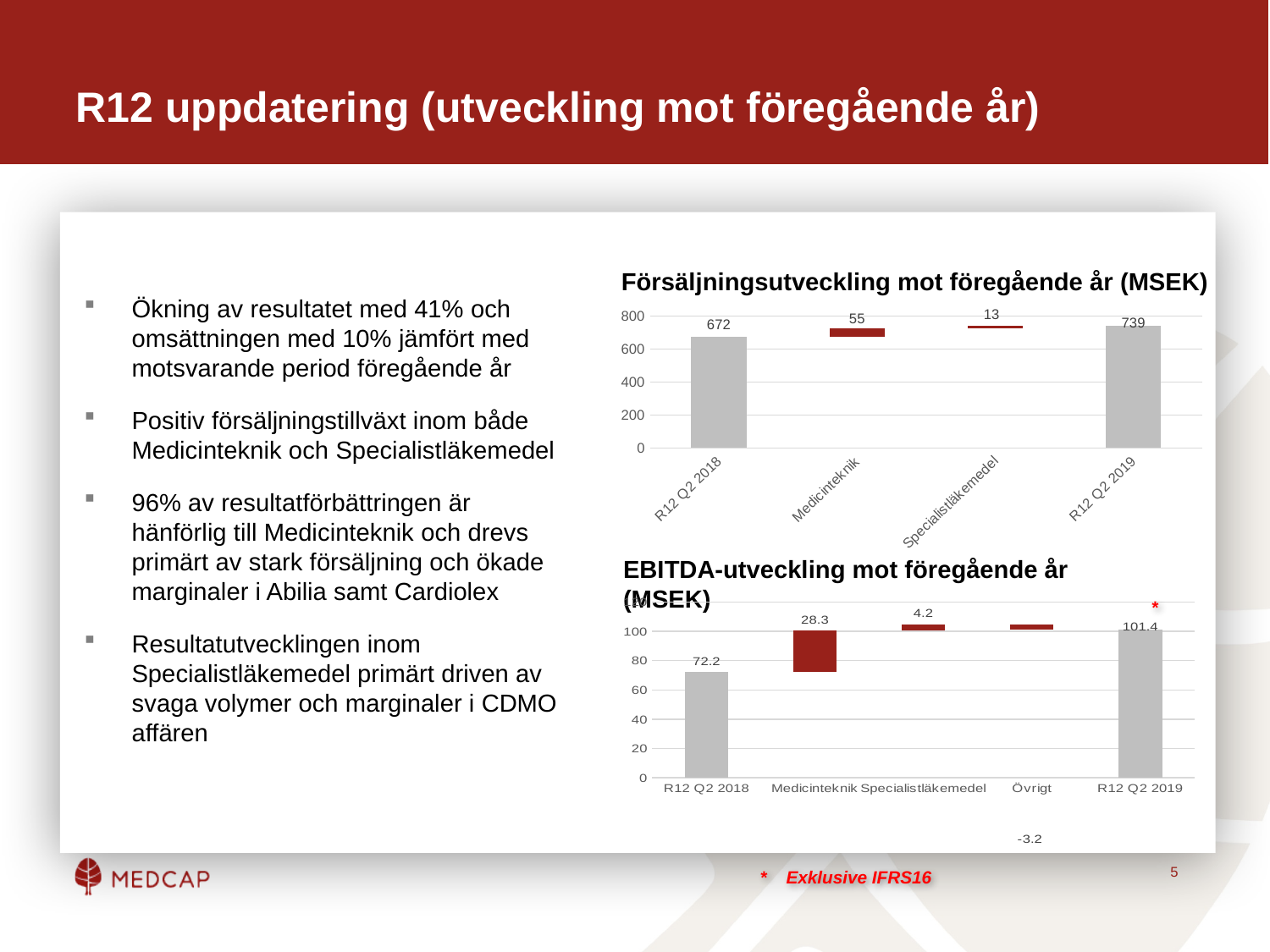
In the 'Försäljningsutveckling mot föregående år (MSEK)' chart, which category has the highest value? R12 Q2 2019 In the 'Försäljningsutveckling mot föregående år (MSEK)' chart, what is the difference between the R12 Q2 2019 and R12 Q2 2018 values? 67 In the 'Försäljningsutveckling mot föregående år (MSEK)' chart, what is the value for R12 Q2 2018? 672 In the 'EBITDA-utveckling mot föregående år (MSEK)' chart, what is the value for R12 Q2 2018? 72.2 What kind of chart is the 'EBITDA-utveckling mot föregående år (MSEK)' chart? Bar chart In the 'EBITDA-utveckling mot föregående år (MSEK)' chart, what is the value shown for Övrigt? -3.2 In the 'EBITDA-utveckling mot föregående år (MSEK)' chart, what is the value for R12 Q2 2019? 101.4 In the 'Försäljningsutveckling mot föregående år (MSEK)' chart, what is the value shown for Medicinteknik? 55 In the 'EBITDA-utveckling mot föregående år (MSEK)' chart, which is larger, the contribution from Medicinteknik or from Specialistläkemedel? Medicinteknik In the 'Försäljningsutveckling mot föregående år (MSEK)' chart, what is the value for R12 Q2 2019? 739 In the 'Försäljningsutveckling mot föregående år (MSEK)' chart, how many categories are shown on the x axis? 4 In the 'EBITDA-utveckling mot föregående år (MSEK)' chart, is the value for R12 Q2 2019 greater or less than 100? greater